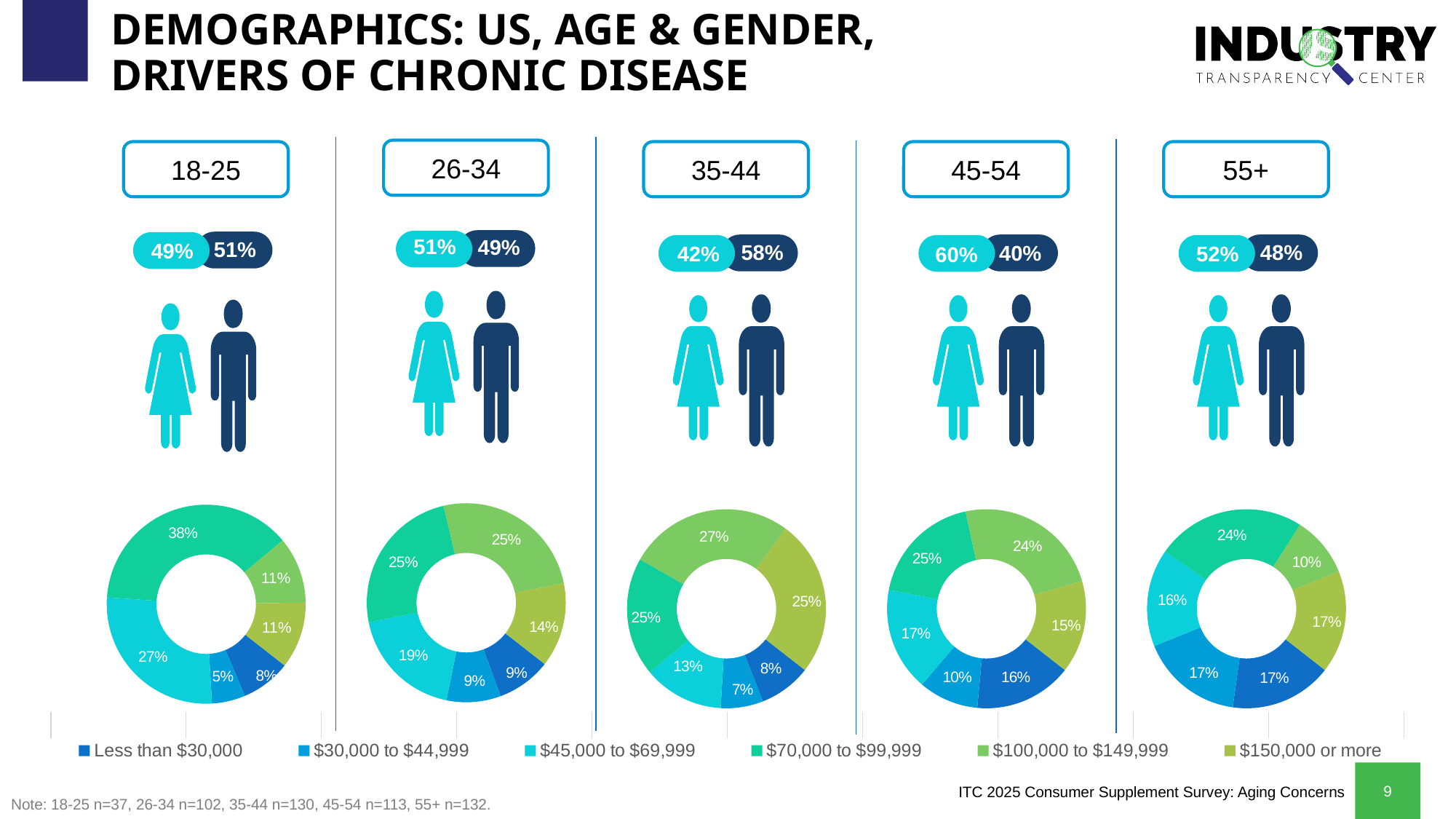
In the 26-34 donut chart, what is the difference between the $45,000 to $69,999 share and the $150,000 or more share? 5% How many donut charts are shown on the slide? 5 In the 55+ donut chart, which income group has the smallest share? $100,000 to $149,999 In the 18-25 donut chart, what share is shown for the $70,000 to $99,999 income group? 38% How many income categories does the legend at the bottom of the slide list? 6 What type of chart is used to show the income distribution for each age group? Donut chart For the 45-54 age group, what percentage is shown for women (the cyan figure)? 60% In the 55+ donut chart, what share is shown for the $70,000 to $99,999 income group? 24% In the 18-25 donut chart, which is larger: the $45,000 to $69,999 share or the $150,000 or more share? $45,000 to $69,999 In the 18-25 donut chart, which income group has the smallest share? $30,000 to $44,999 In the 35-44 donut chart, what share is shown for the $150,000 or more income group? 25% In the 45-54 donut chart, what share is shown for the Less than $30,000 income group? 16%